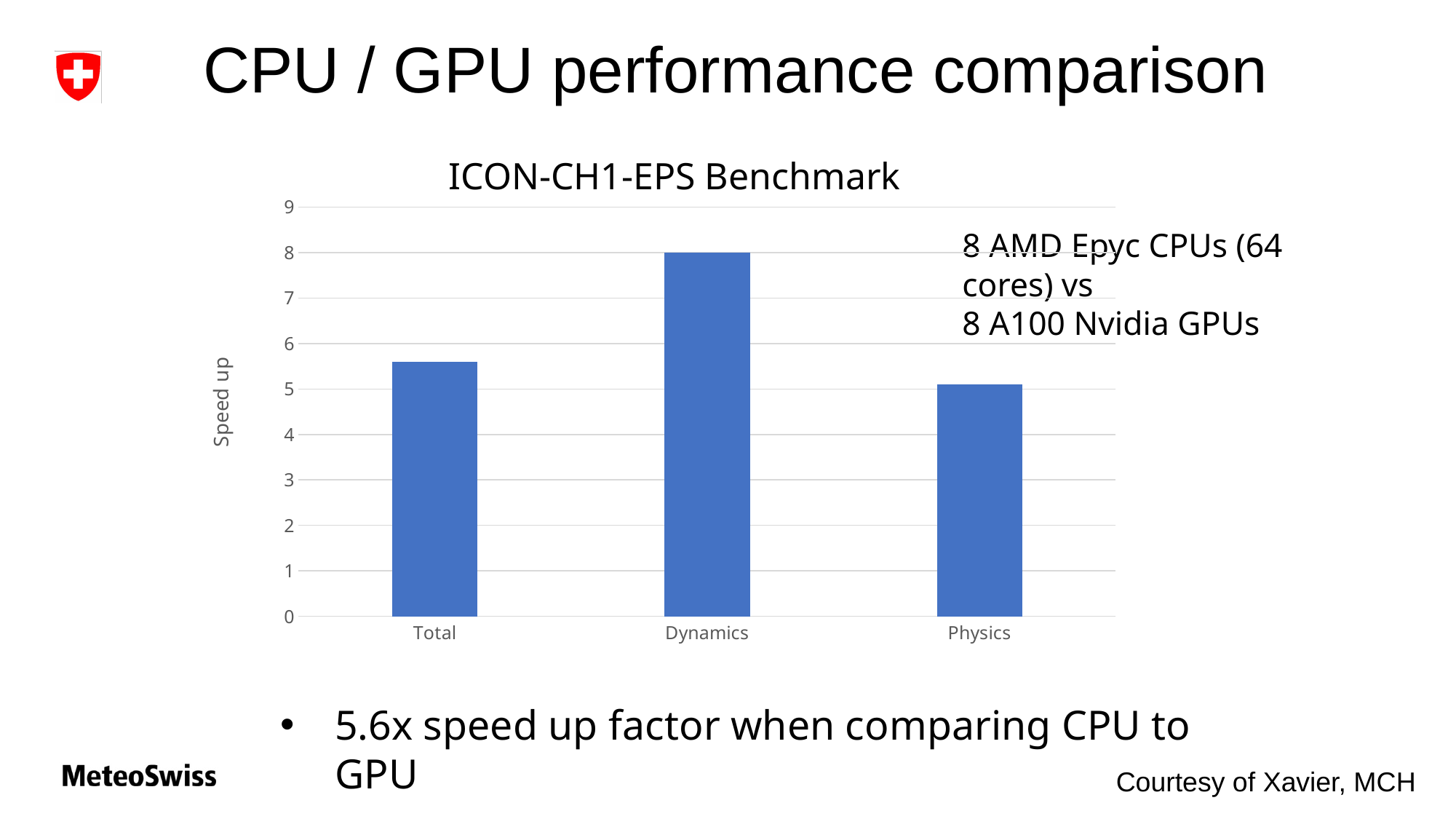
Is the speed up value for Total greater or less than 5? greater Which category has the highest speed up in the ICON-CH1-EPS Benchmark chart? Dynamics Is the speed up value for Total greater or less than 6? less Is the speed up value for Dynamics greater or less than 7? greater What is the title of the chart? ICON-CH1-EPS Benchmark How many categories are plotted in the ICON-CH1-EPS Benchmark chart? 3 What is the speed up value for Dynamics? 8 Which category has the lowest speed up in the ICON-CH1-EPS Benchmark chart? Physics Which has a larger speed up, Total or Physics? Total What is the label on the vertical axis of the chart? Speed up What kind of chart is shown on the slide? bar chart